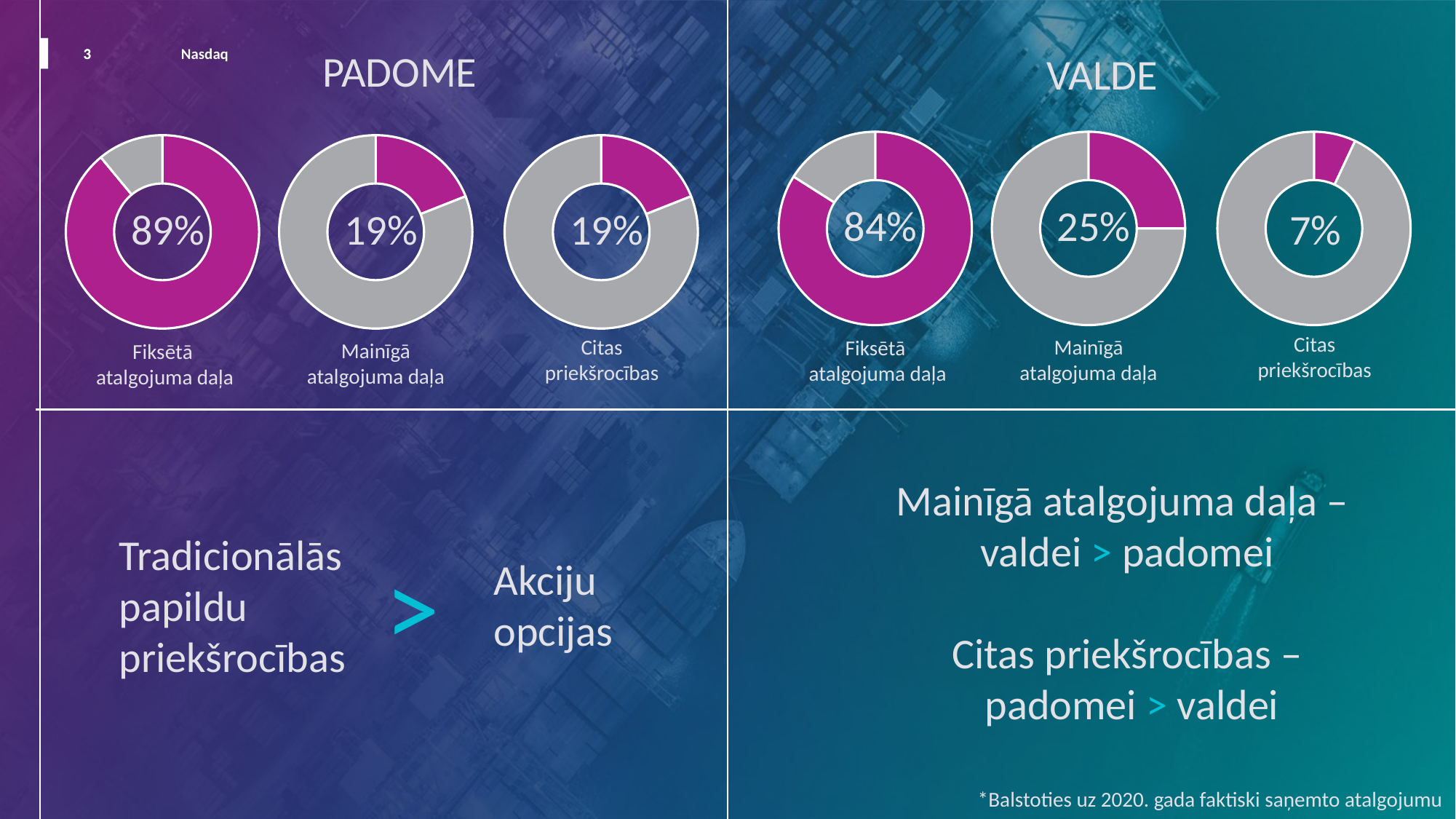
In the VALDE section, what percentage is shown in the 'Mainīgā atalgojuma daļa' donut chart? 25% Which of the three PADOME donut charts shows the highest percentage? Fiksētā atalgojuma daļa What type of chart is used to display the percentages on the slide? Donut (pie) chart Which is larger: the 'Citas priekšrocības' percentage for PADOME or for VALDE? PADOME In the PADOME section, what percentage is shown in the 'Mainīgā atalgojuma daļa' donut chart? 19% In the PADOME section, what percentage is shown in the 'Citas priekšrocības' donut chart? 19% In the PADOME section, what percentage is shown in the 'Fiksētā atalgojuma daļa' donut chart? 89% In the VALDE section, what percentage is shown in the 'Fiksētā atalgojuma daļa' donut chart? 84% What is the difference between the 'Mainīgā atalgojuma daļa' percentage for VALDE and for PADOME? 6% In the VALDE section, what percentage is shown in the 'Citas priekšrocības' donut chart? 7% How many donut charts are shown on the slide in total? 6 Which of the three VALDE donut charts shows the lowest percentage? Citas priekšrocības